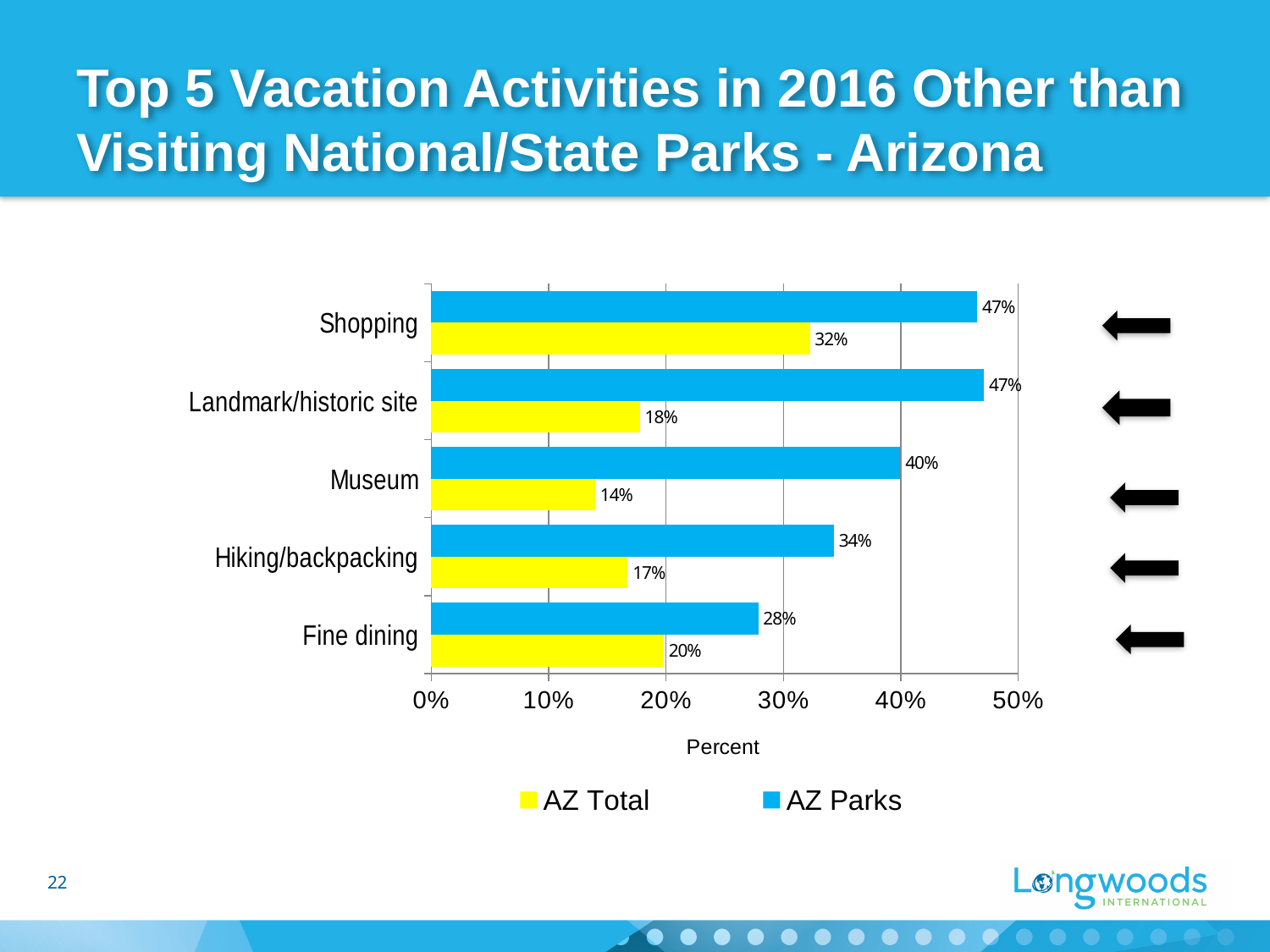
What is the AZ Total value for Landmark/historic site? 18% What kind of chart is shown on the slide? Bar chart What is the AZ Parks value for Museum? 40% How many activities are shown on the chart? 5 Which is larger, the AZ Total value for Fine dining or the AZ Total value for Hiking/backpacking? Fine dining What is the label of the horizontal axis? Percent What is the difference between the AZ Parks and AZ Total values for Shopping? 15% What is the difference between the AZ Parks and AZ Total values for Landmark/historic site? 29% Which activity has the lowest AZ Total value? Museum How many series does the legend list? 2 What is the AZ Parks value for Fine dining? 28% Which activity has the lowest AZ Parks value? Fine dining